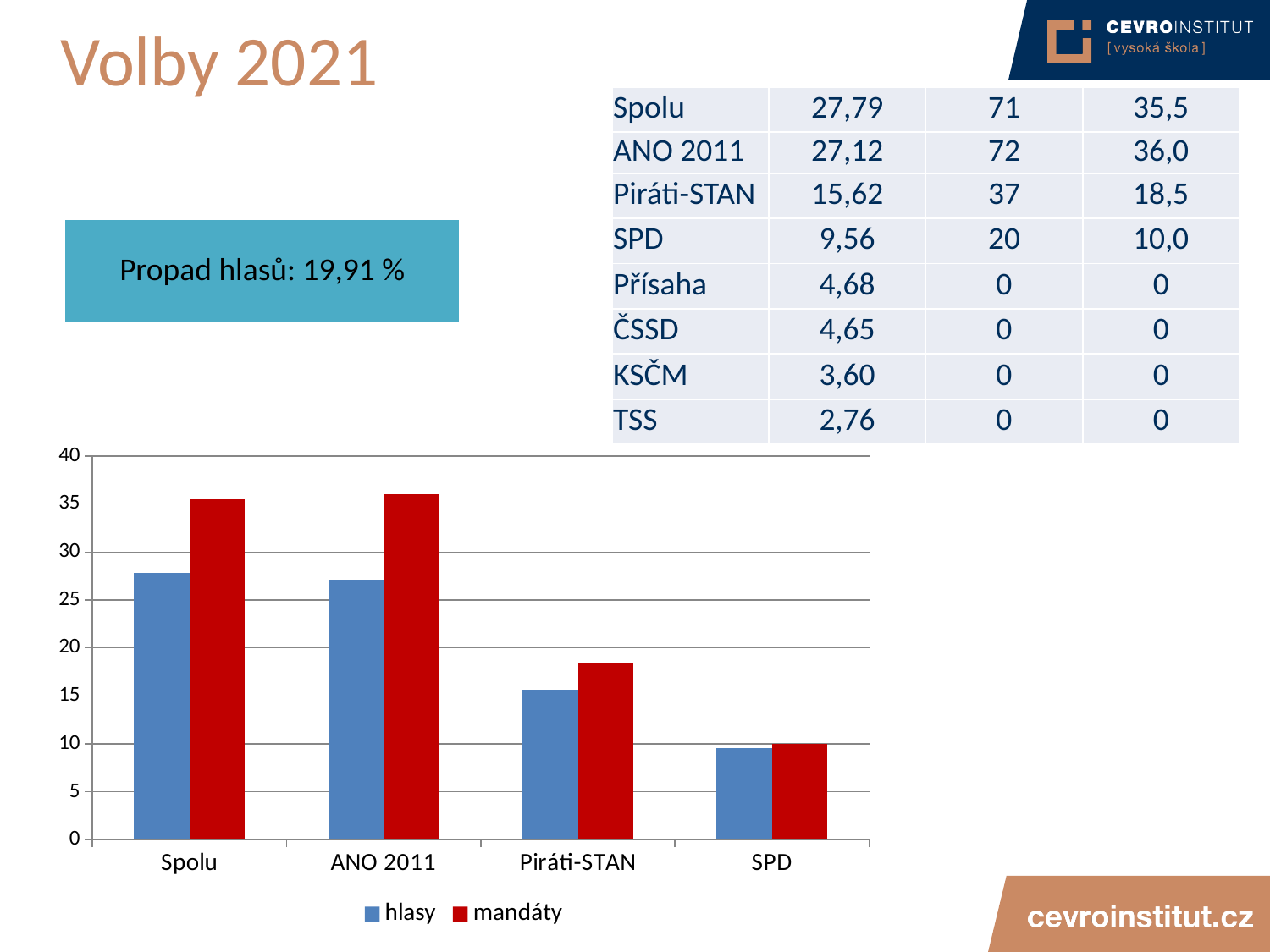
What colour are the mandáty bars in the chart? red Do the hlasy values rise or fall from left to right across the categories? fall For Piráti-STAN, which is larger in the chart: hlasy or mandáty? mandáty Is the mandáty value for ANO 2011 greater or less than 30? greater For Spolu, which is larger in the chart: hlasy or mandáty? mandáty What kind of chart is shown on the slide? bar chart Which category has the lowest value for hlasy in the chart? SPD Is the mandáty value for Piráti-STAN greater or less than 20? less Which category has the lowest value for mandáty in the chart? SPD How many categories are shown on the x axis of the chart? 4 How many series does the chart legend list? 2 Is the hlasy value for Spolu greater or less than 25? greater